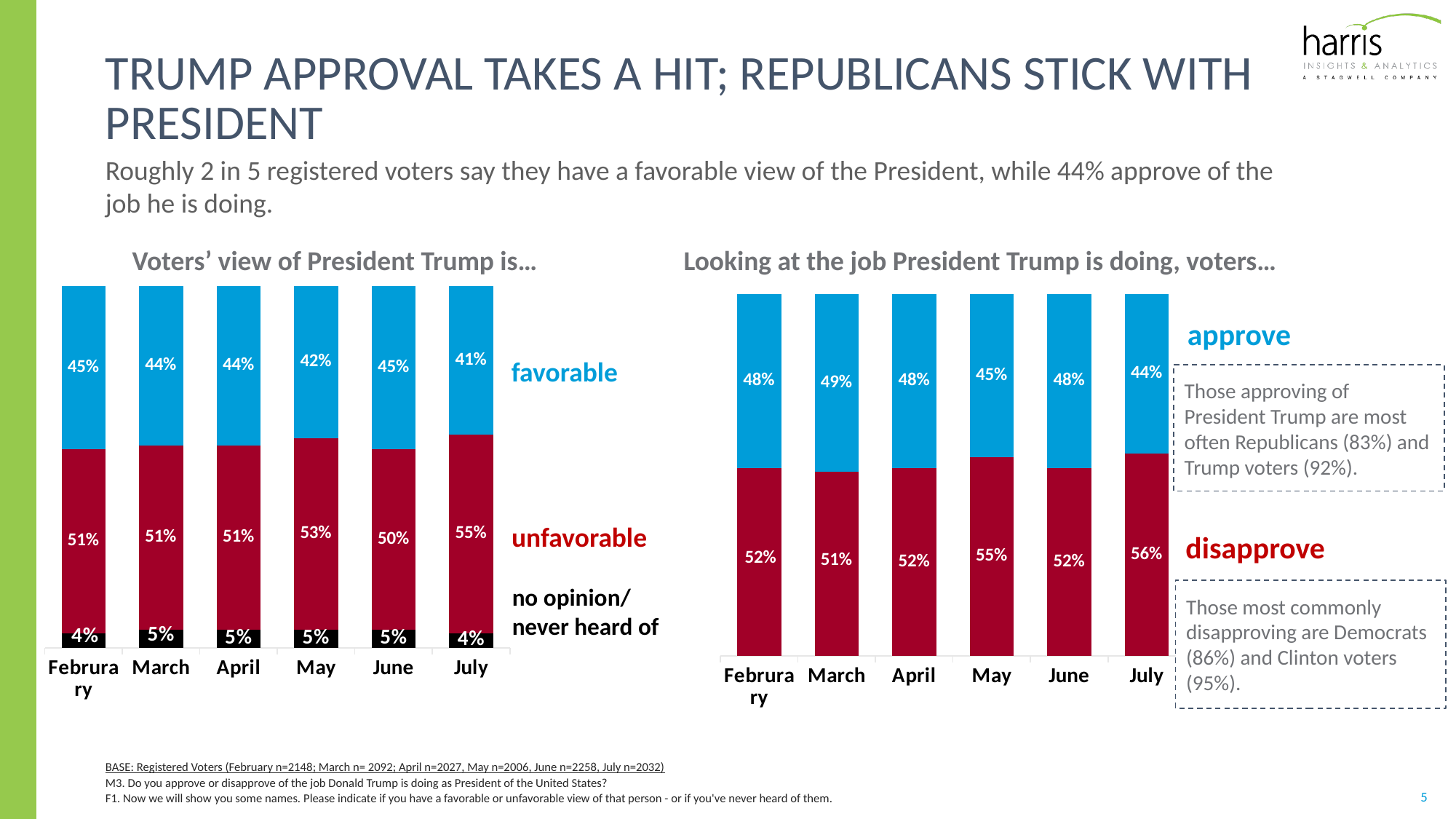
In the chart 'Voters' view of President Trump is…', which month has the highest unfavorable value? July What type of chart is 'Looking at the job President Trump is doing, voters…'? Stacked bar chart In the chart 'Voters' view of President Trump is…', what is the favorable value for July? 41% In the chart 'Voters' view of President Trump is…', what is the total of the three segments for the March bar? 100% In the chart 'Voters' view of President Trump is…', what is the unfavorable value for May? 53% In the chart 'Looking at the job President Trump is doing, voters…', what is the disapprove value for July? 56% In the chart 'Looking at the job President Trump is doing, voters…', what is the approve value for March? 49% How many months are shown on the x axis of the chart 'Voters' view of President Trump is…'? 6 In the chart 'Looking at the job President Trump is doing, voters…', what is the difference between the disapprove and approve values for July? 12% In the chart 'Voters' view of President Trump is…', is the favorable value for February larger or smaller than the favorable value for July? larger In the chart 'Looking at the job President Trump is doing, voters…', which month has the lowest approve value? July How many series are shown in the chart 'Voters' view of President Trump is…'? 3